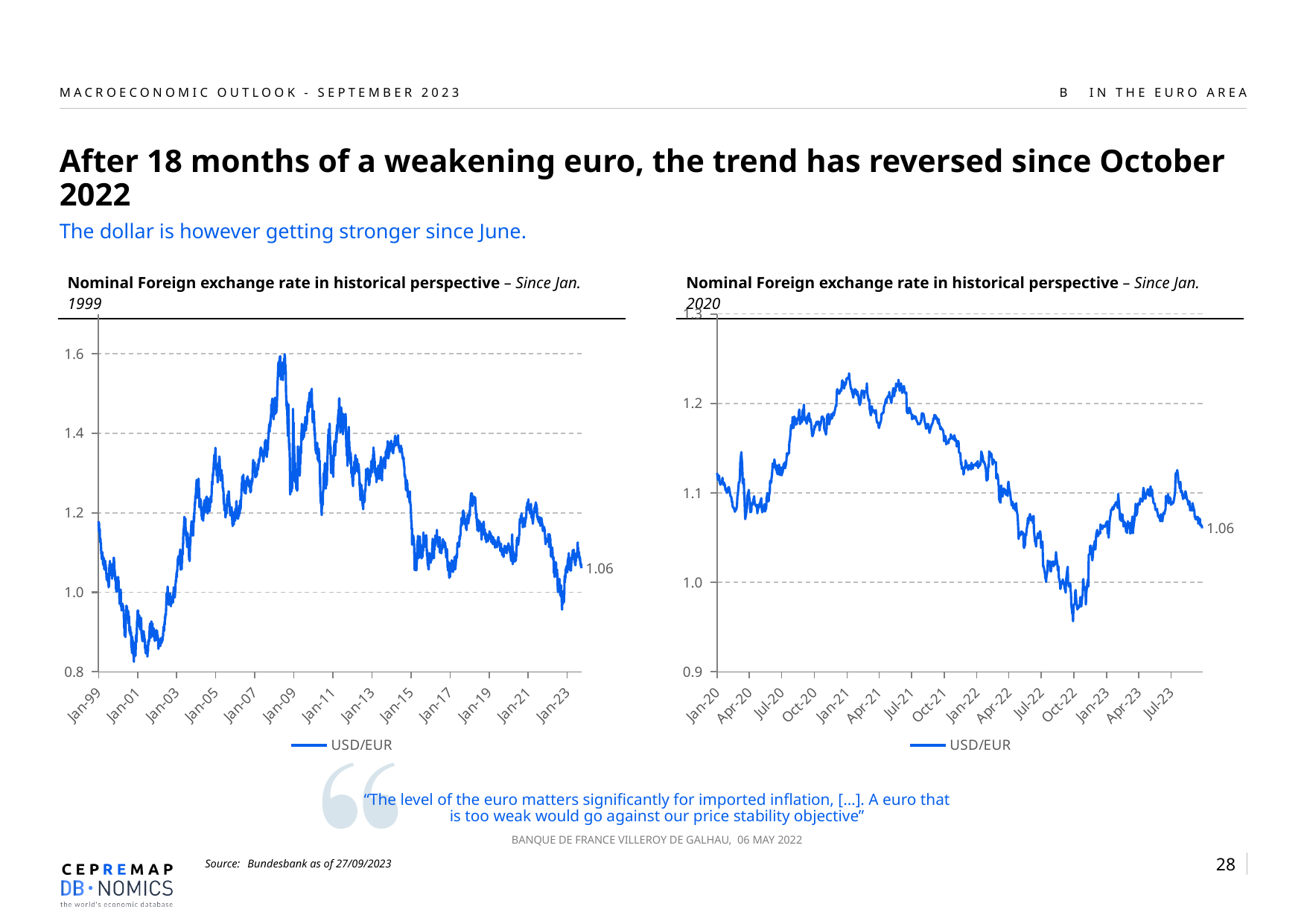
What kind of chart is the left chart, 'Nominal Foreign exchange rate in historical perspective – Since Jan. 1999'? Line chart In the right chart (since Jan. 2020), is the USD/EUR value around Jan-21 greater or less than 1.2? greater In the right chart (since Jan. 2020), around which month does the USD/EUR rate reach its lowest point? Oct-22 In the right chart (since Jan. 2020), does the USD/EUR rate rise or fall between Jan-21 and Oct-22? Fall In the left chart (since Jan. 1999), is the peak USD/EUR value around 2008 greater or less than 1.4? greater In the left chart (since Jan. 1999), is the USD/EUR value at Jan-99 greater or less than the value at Jan-01? Jan-99 is greater In the left chart (since Jan. 1999), is the USD/EUR value around Jan-01 greater or less than 1.0? less In the left chart (since Jan. 1999), what is the latest USD/EUR value labelled at the end of the line? 1.06 In the right chart (since Jan. 2020), what is the latest USD/EUR value labelled at the end of the line? 1.06 What series name appears in the legend of the left chart (since Jan. 1999)? USD/EUR How many series does the legend of the right chart (since Jan. 2020) list? 1